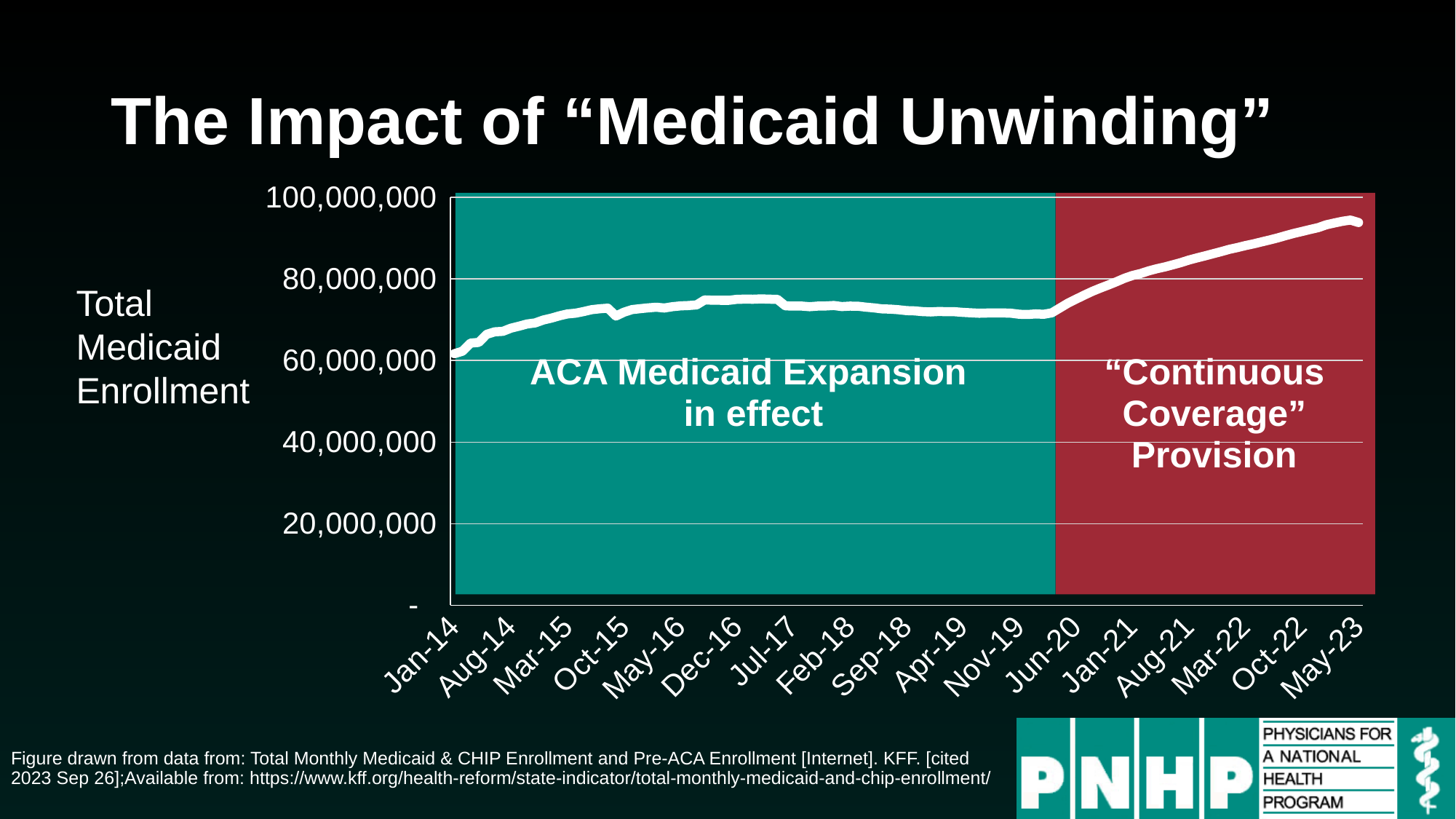
How many date labels are shown on the x axis? 17 What quantity does the y axis of the chart represent, according to the label to its left? Total Medicaid Enrollment Is the value for Dec-16 greater or less than 60,000,000? greater Which is larger, the value for May-23 or the value for Jan-14? May-23 Which x-axis date has the lowest enrollment value? Jan-14 Do the values rise or fall along the x axis from Jun-20 to May-23? rise Is the value for May-23 greater or less than 80,000,000? greater What kind of chart is shown on the slide? line chart Is the value for Jun-20 greater or less than 80,000,000? less What is the title of the slide containing the chart? The Impact of "Medicaid Unwinding" Which x-axis date has the highest enrollment value? May-23